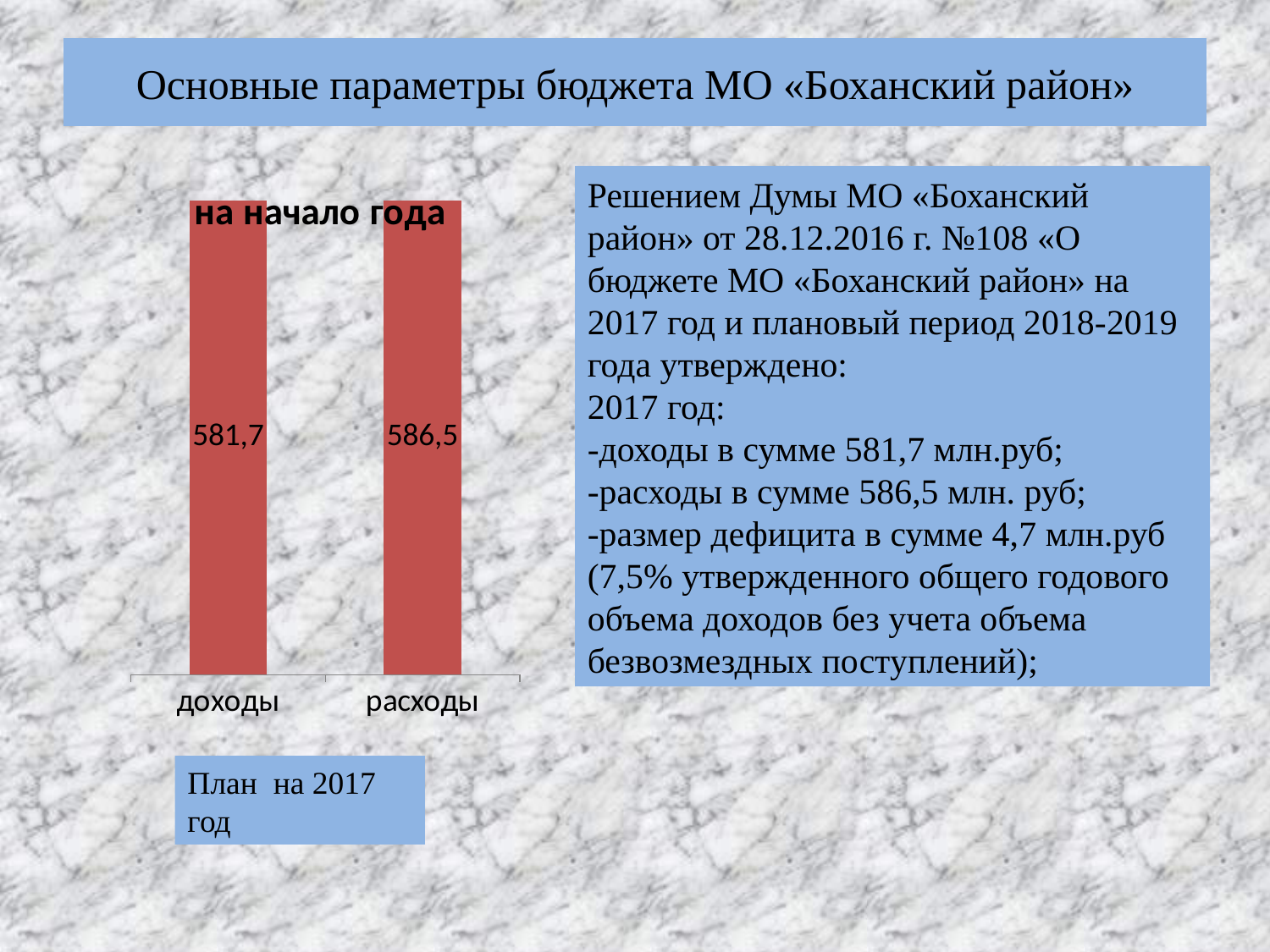
Is the value for расходы larger or smaller than the value for доходы? larger How many categories are shown in the chart? 2 What is the title of the chart? на начало года What is the difference between the values for расходы and доходы? 4,8 Which category has the higher value in the chart? расходы What colour are the bars in the chart? red What is the value for доходы in the chart? 581,7 What is the value for расходы in the chart? 586,5 Which category has the lower value in the chart? доходы What type of chart is shown on the slide? bar chart